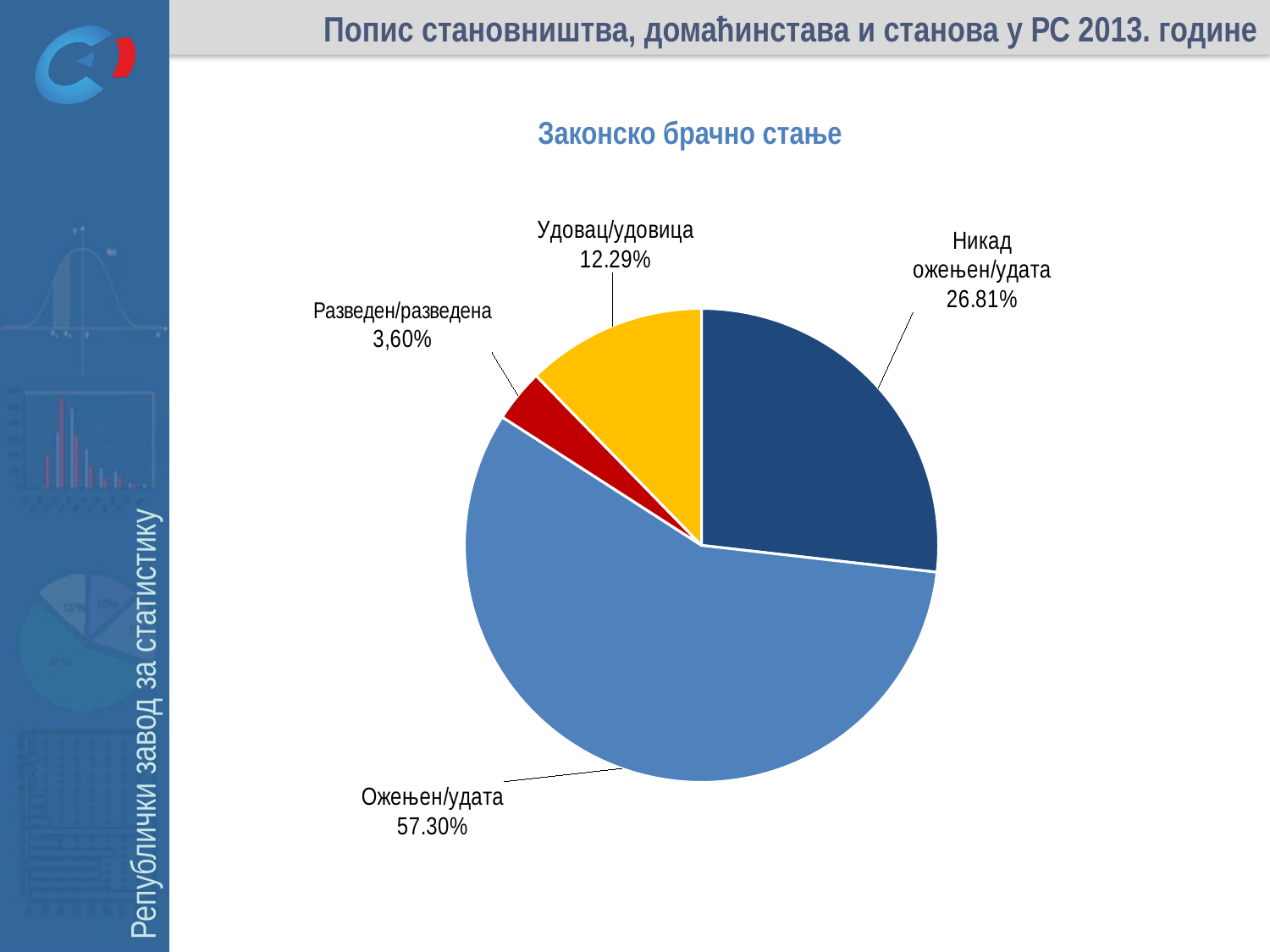
What is the difference in percentage points between Ожењен/удата and Никад ожењен/удата? 30.49 What is the value shown for Удовац/удовица? 12.29% What is the value shown for Никад ожењен/удата? 26.81% Which is larger, the slice for Никад ожењен/удата or the slice for Удовац/удовица? Никад ожењен/удата What is the value shown for Разведен/разведена? 3,60% Which category has the largest slice of the pie? Ожењен/удата How many slices does the pie chart have? 4 What share of the pie is labelled Ожењен/удата? 57.30% What is the title of the chart? Законско брачно стање Which category has the smallest slice of the pie? Разведен/разведена What kind of chart is shown on the slide? pie chart What colour is the slice for Удовац/удовица? yellow